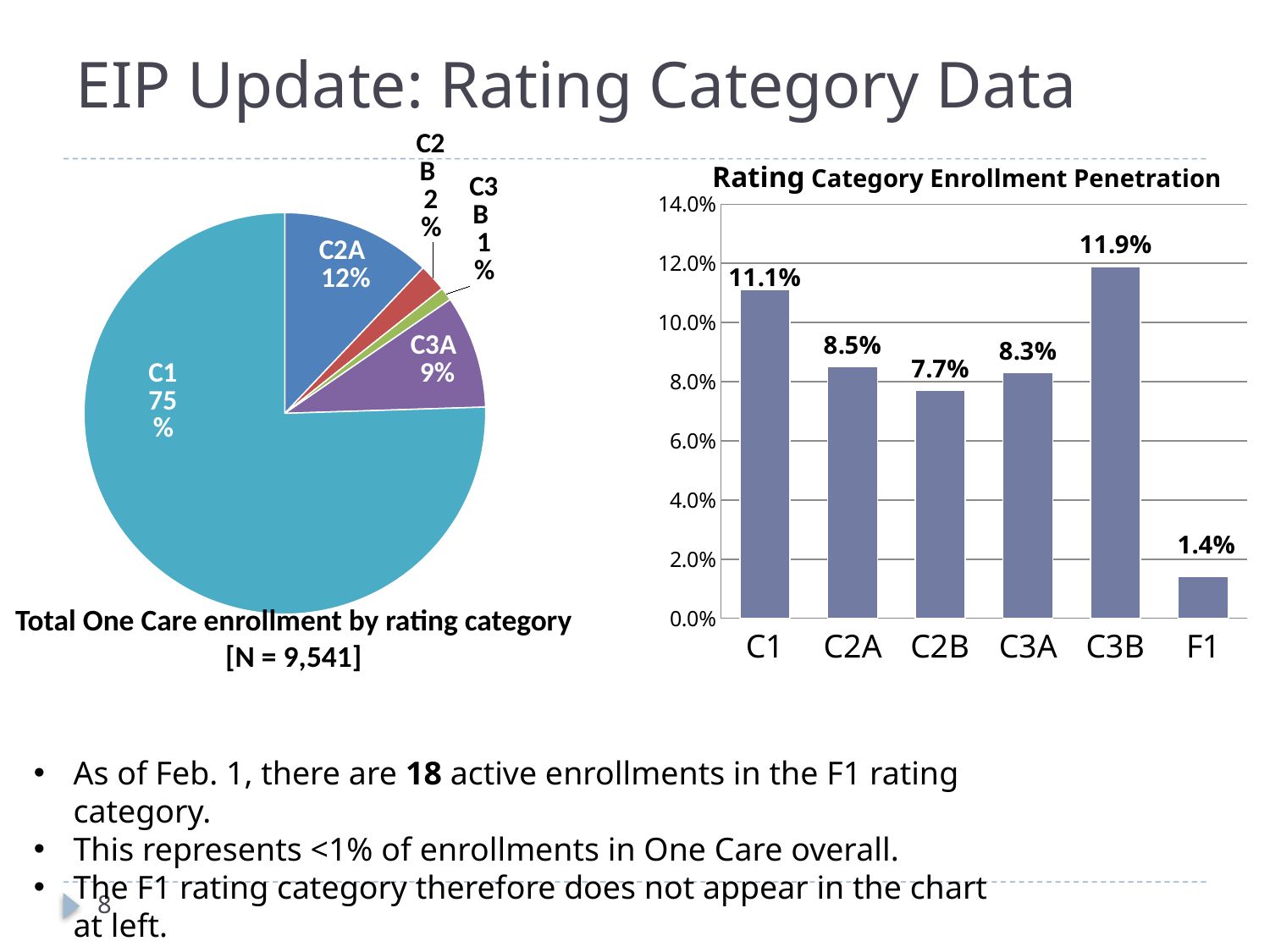
What kind of chart is the 'Rating Category Enrollment Penetration' chart? bar chart In the pie chart 'Total One Care enrollment by rating category', what share does C1 have? 75% In the pie chart 'Total One Care enrollment by rating category', what share does C3A have? 9% In the pie chart 'Total One Care enrollment by rating category', which category has the smallest slice? C3B In the 'Rating Category Enrollment Penetration' chart, which category has the lowest value? F1 In the 'Rating Category Enrollment Penetration' chart, what is the difference between the values for C1 and F1? 9.7% In the 'Rating Category Enrollment Penetration' chart, which category has the highest value? C3B How many categories are shown in the 'Rating Category Enrollment Penetration' chart? 6 In the 'Rating Category Enrollment Penetration' chart, which is larger, the value for C2A or the value for C3A? C2A In the 'Rating Category Enrollment Penetration' chart, what is the value for C2B? 7.7% In the 'Rating Category Enrollment Penetration' chart, what is the value for C3B? 11.9% What is the N value shown in the title of the pie chart on the left? 9,541